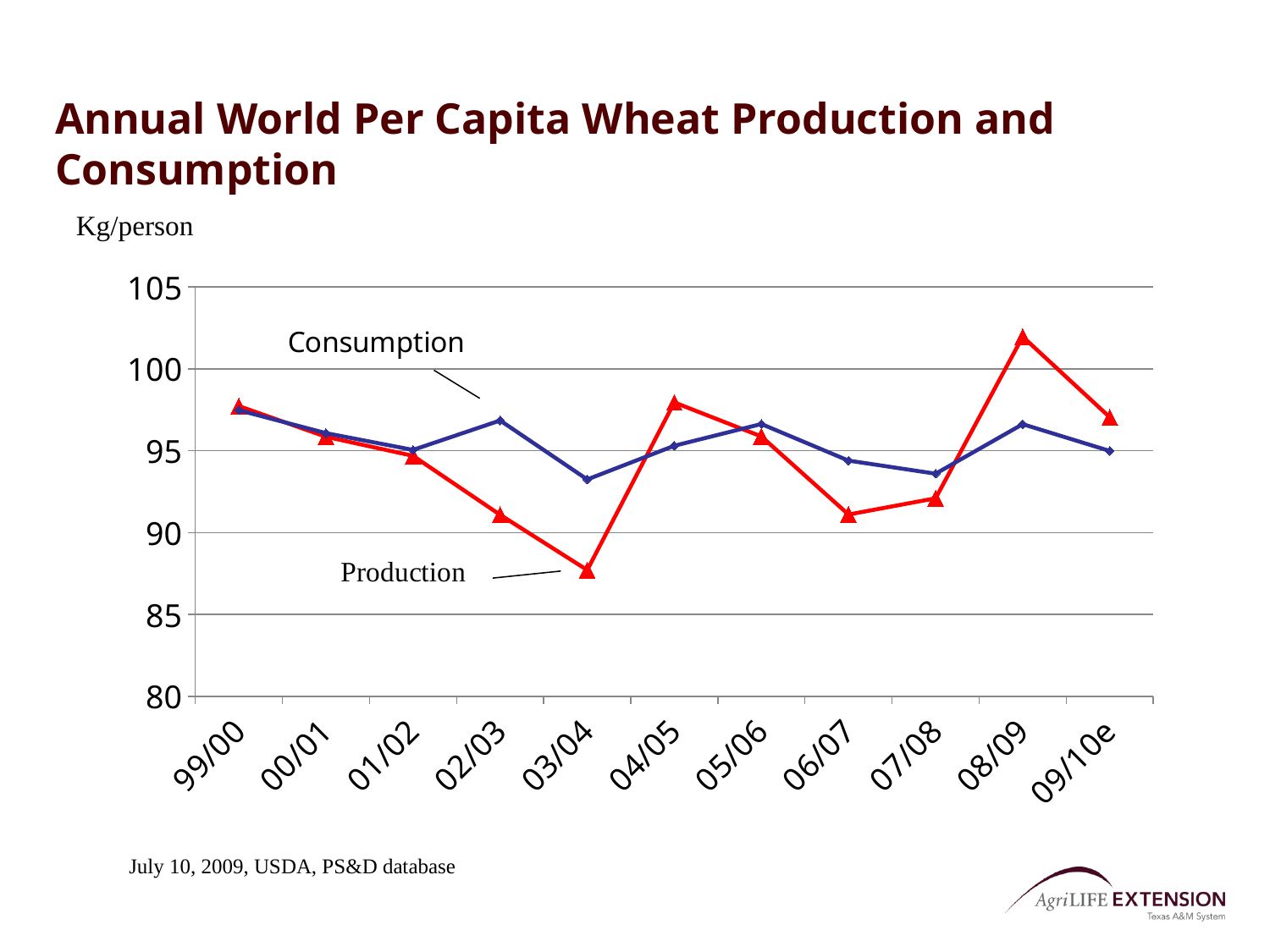
What kind of chart is shown on the slide? line chart Is the value for Consumption in 08/09 greater or less than 100? less How many marketing years are plotted along the x axis? 11 How many series (lines) are plotted on the chart? 2 In which year does Production reach its highest value? 08/09 Does Production rise or fall from 01/02 to 03/04? fall What unit is shown above the y axis of the chart? Kg/person Is the value for Consumption in 03/04 greater or less than 90? greater Is the value for Production in 08/09 greater or less than 100? greater In 03/04, which is larger, Consumption or Production? Consumption In which year does Production reach its lowest value? 03/04